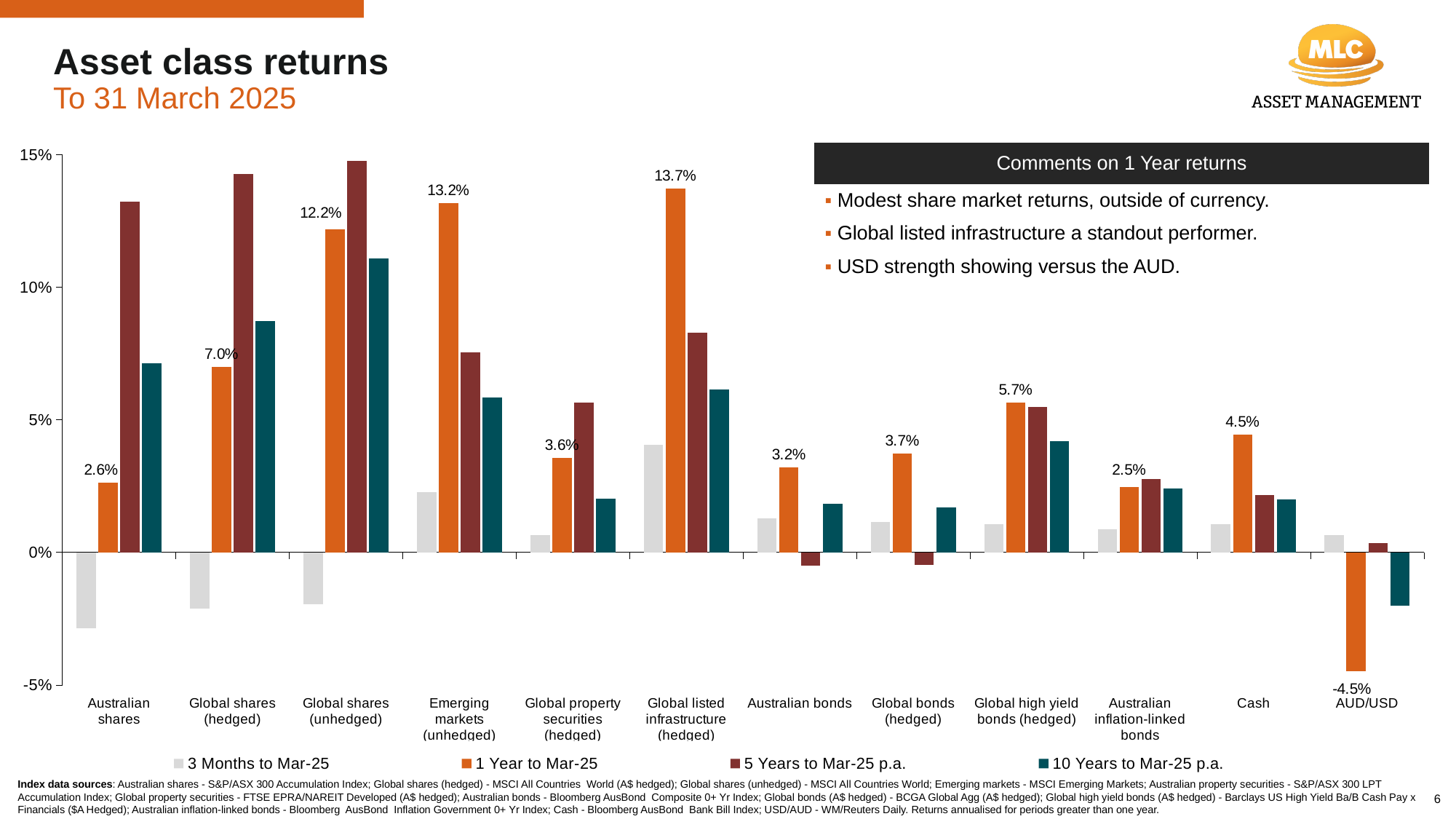
Is the 5 Years to Mar-25 p.a. value for Australian shares greater or less than 10%? greater What is the 1 Year to Mar-25 return for Global listed infrastructure (hedged)? 13.7% What is the difference between the 1 Year to Mar-25 returns for Global shares (unhedged) and Global shares (hedged)? 5.2% Which has the larger 1 Year to Mar-25 return, Cash or Australian bonds? Cash How many asset classes are shown on the x axis of the chart? 12 What is the 1 Year to Mar-25 return for Emerging markets (unhedged)? 13.2% What is the 1 Year to Mar-25 return for AUD/USD? -4.5% What type of chart is shown on the slide? Bar chart Which asset class has the highest 1 Year to Mar-25 return? Global listed infrastructure (hedged) How many series does the chart legend list? 4 Is the 10 Years to Mar-25 p.a. value for Global shares (unhedged) greater or less than 10%? greater Which asset class has the lowest 1 Year to Mar-25 return? AUD/USD